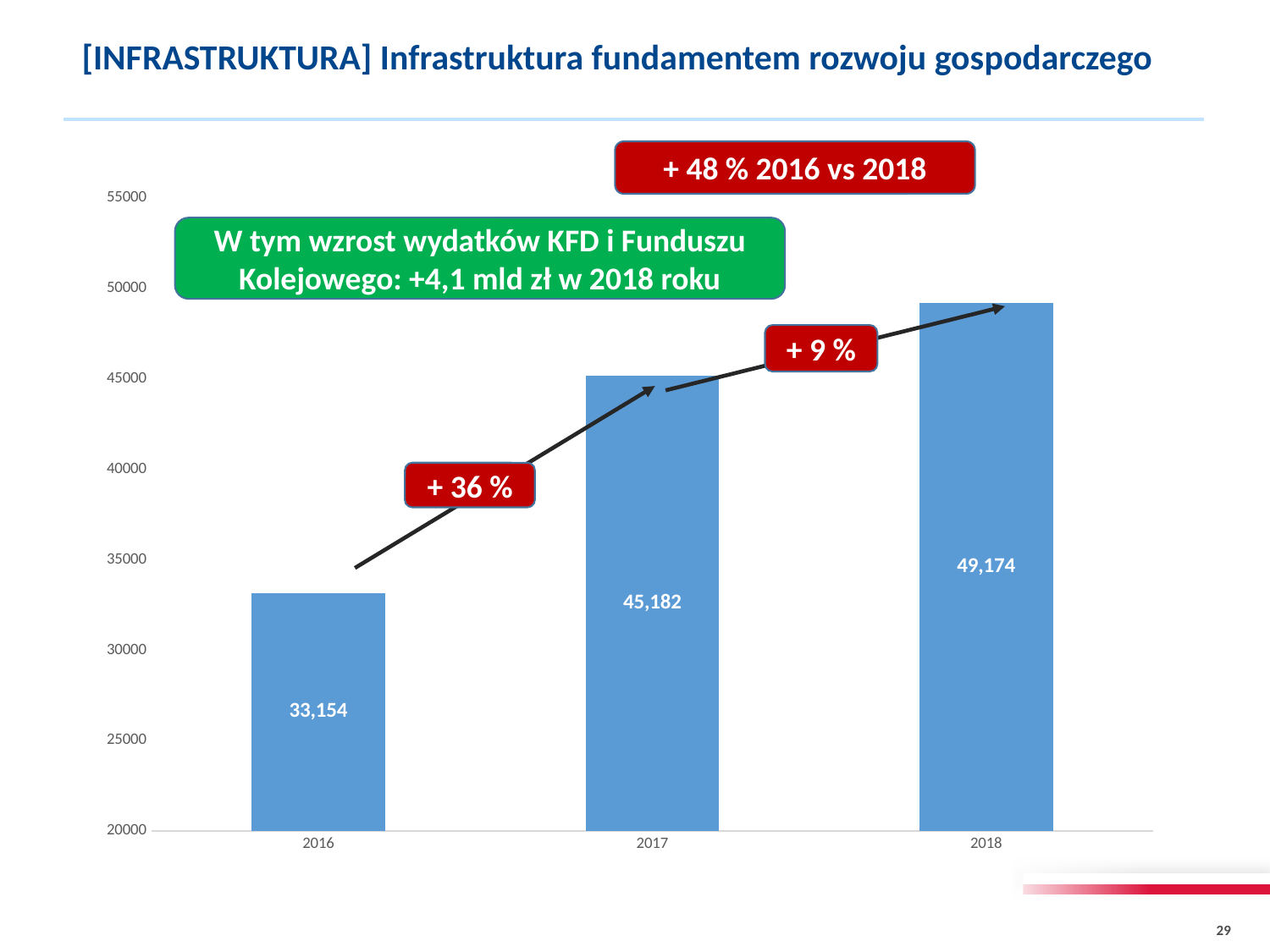
Do the values rise or fall from 2016 to 2018? rise What is the value for 2018? 49,174 What kind of chart is shown on the slide? bar chart How many years are shown on the x axis? 3 What is the value for 2017? 45,182 What is the difference between the values for 2017 and 2016? 12,028 Is the value for 2016 greater or less than 35000? less Which year has the highest value? 2018 Which is larger, the value for 2017 or the value for 2018? 2018 Which year has the lowest value? 2016 What is the value for 2016? 33,154 What is the difference between the values for 2018 and 2016? 16,020